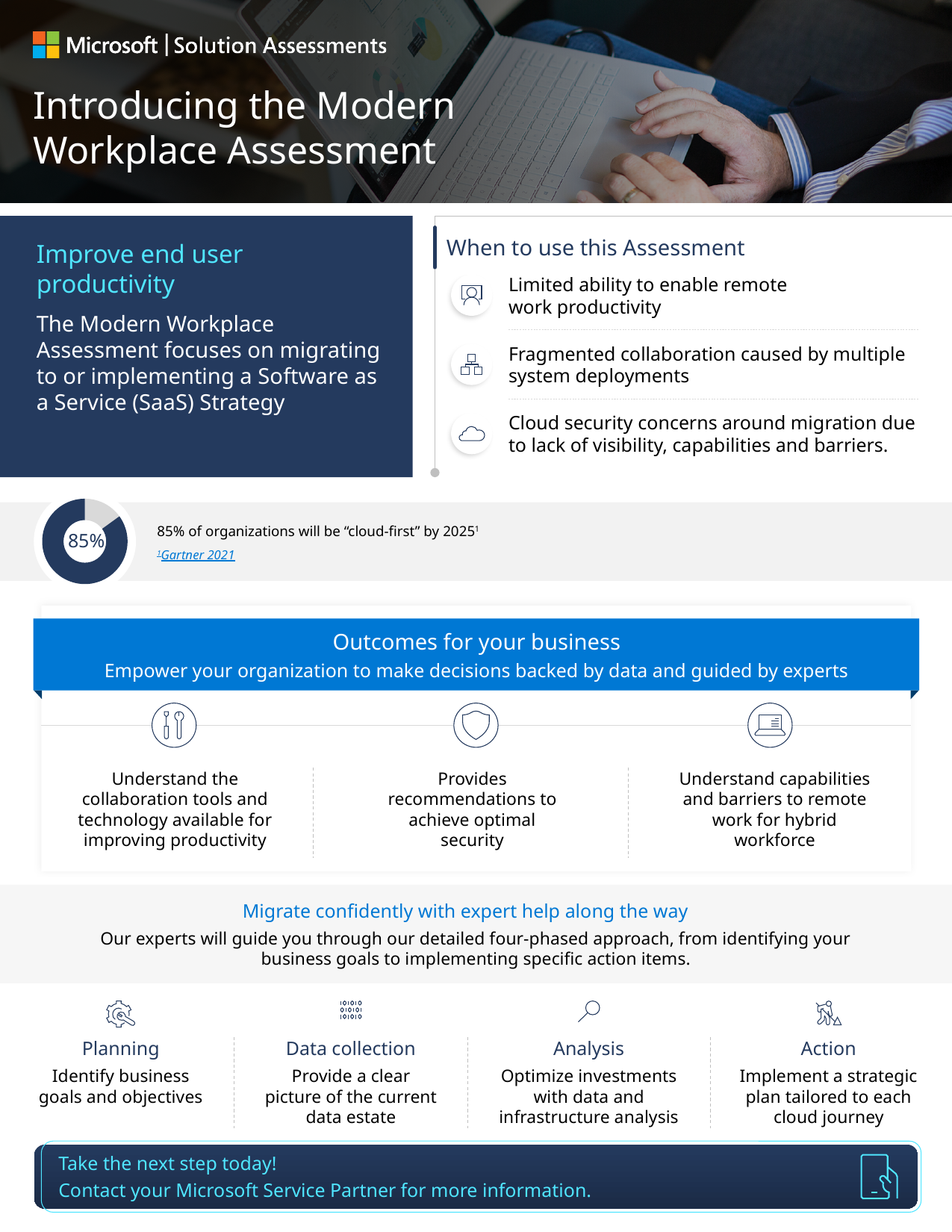
What value is printed in the centre of the doughnut chart? 85% According to the doughnut chart, what share of organizations will be "cloud-first" by 2025? 85% What source is cited for the statistic shown in the doughnut chart? Gartner 2021 What kind of chart is shown next to the statement about organizations being "cloud-first" by 2025? Pie (doughnut) chart Which segment of the doughnut chart is larger, the dark blue filled segment or the light grey segment? The dark blue filled segment What year does the statistic in the doughnut chart refer to? 2025 How many segments does the doughnut chart have? 2 What share of the doughnut chart is left unfilled (the light grey segment)? 15% Is the filled portion of the doughnut chart greater or less than 50%? greater